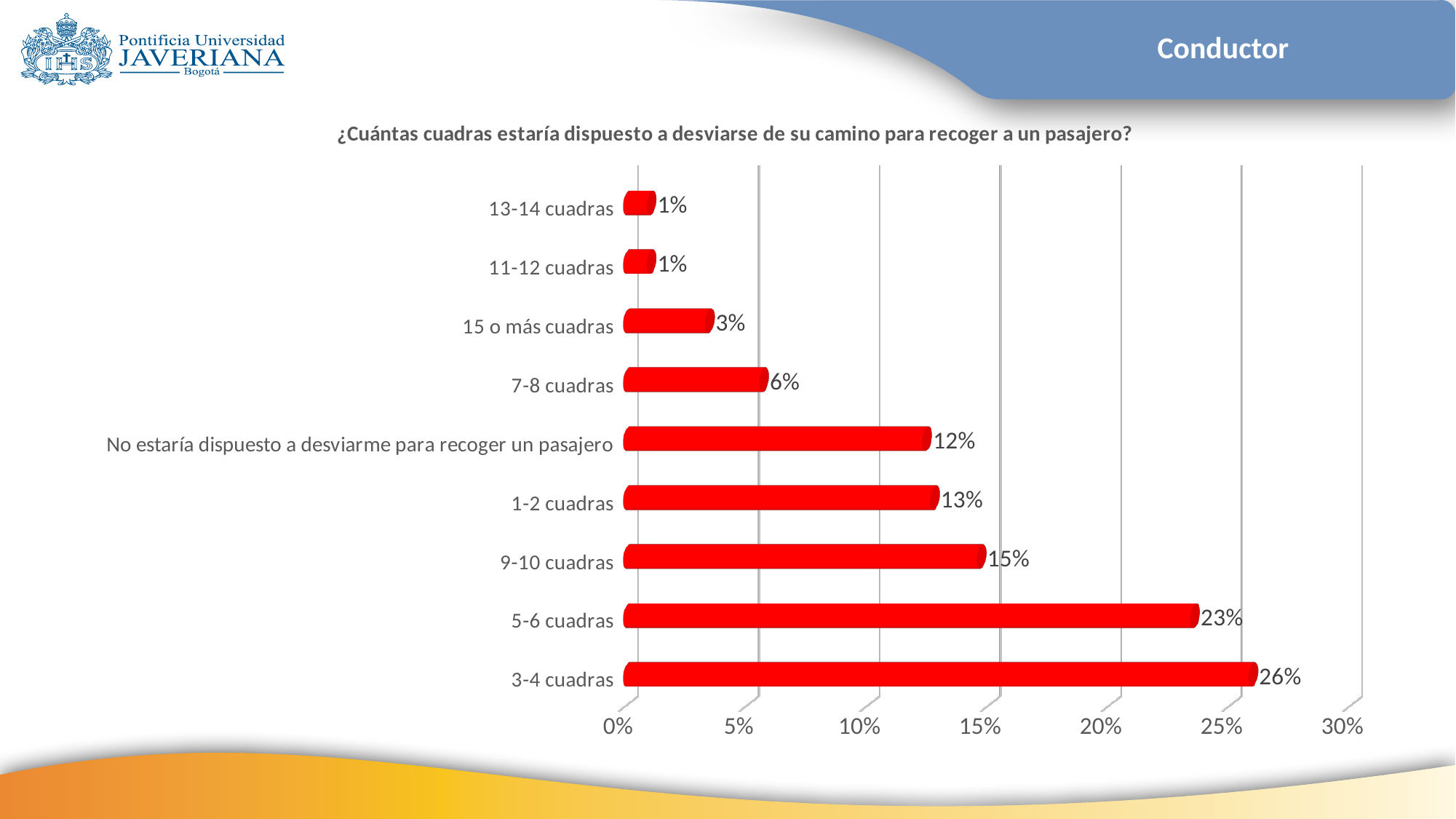
What kind of chart is shown on the slide? Bar chart What is the difference between the values for "3-4 cuadras" and "5-6 cuadras"? 3% Which is larger, the value for "9-10 cuadras" or the value for "1-2 cuadras"? 9-10 cuadras What is the title of the chart? ¿Cuántas cuadras estaría dispuesto a desviarse de su camino para recoger a un pasajero? Is the value for "5-6 cuadras" greater or less than 20%? greater What is the difference between the values for "1-2 cuadras" and "7-8 cuadras"? 7% What percentage of respondents chose "3-4 cuadras"? 26% What is the value shown for "9-10 cuadras"? 15% Which category has the highest value? 3-4 cuadras What percentage is shown for "No estaría dispuesto a desviarme para recoger un pasajero"? 12% What is the value for "15 o más cuadras"? 3% How many categories are shown in the chart? 9